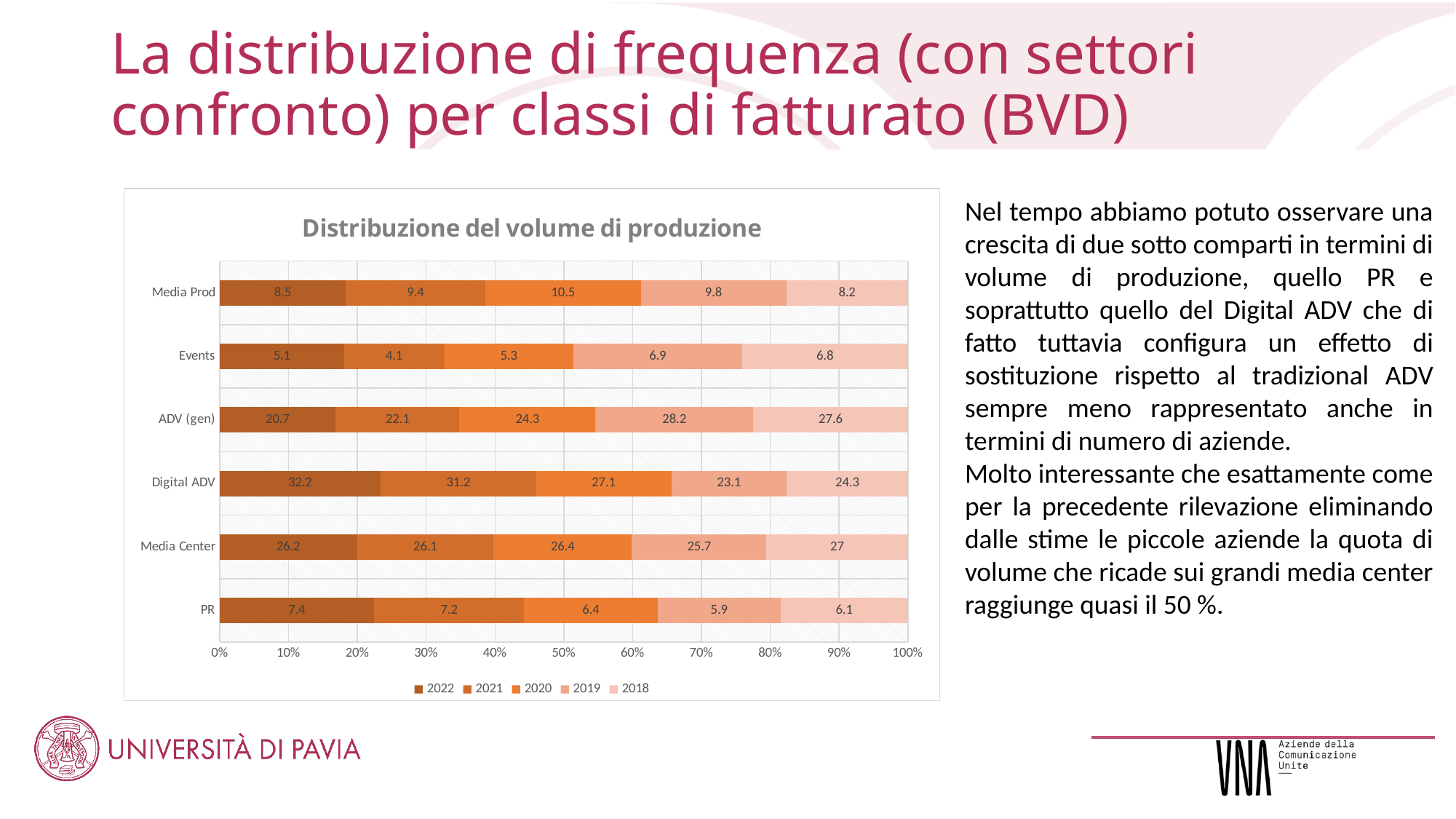
What is the title of the chart? Distribuzione del volume di produzione What is the difference between the 2019 and 2022 values for ADV (gen)? 7.5 What is the value for Digital ADV in the 2022 series? 32.2 What is the value for Events in the 2019 series? 6.9 What is the value for Media Center in the 2018 series? 27 How many categories are shown on the y axis? 6 What kind of chart is shown? Stacked bar chart Which category has the lowest value in the 2021 series? Events How many series does the legend list? 5 Which category has the highest value in the 2022 series? Digital ADV Which is larger for PR: the 2022 value or the 2018 value? 2022 What is the value for ADV (gen) in the 2020 series? 24.3